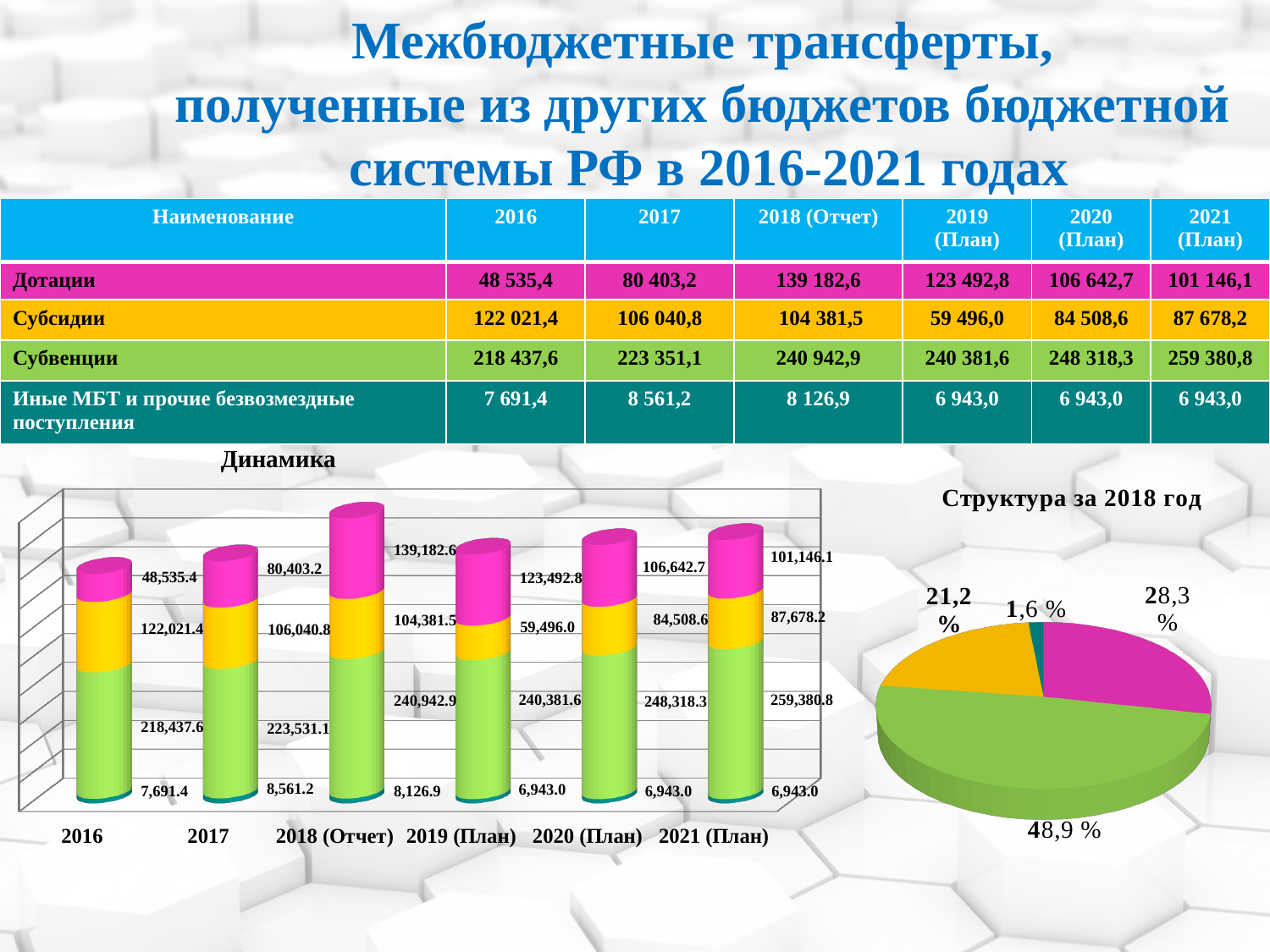
In the "Динамика" chart, what is the value of the pink (Дотации) segment for 2018 (Отчет)? 139,182.6 In the "Динамика" chart, is the yellow (Субсидии) segment larger in 2016 or in 2017? 2016 In the "Динамика" chart, what is the total of all four segments of the 2019 (План) bar? 430,313.4 In the "Динамика" chart, what is the value of the green (Субвенции) segment for 2021 (План)? 259,380.8 In the "Динамика" chart, does the pink (Дотации) segment rise or fall from 2018 (Отчет) to 2021 (План)? Falls In the pie chart "Структура за 2018 год", what share does the smallest slice have? 1,6 % In the "Динамика" chart, how many years (categories) are shown on the x axis? 6 In the pie chart "Структура за 2018 год", what share does the largest (green) slice have? 48,9 % What kind of chart is the "Динамика" chart on the left? Stacked bar chart In the "Динамика" chart, by how much does the pink (Дотации) value for 2018 (Отчет) exceed the pink value for 2017? 58,779.4 In the "Динамика" chart, which year has the largest green (Субвенции) segment? 2021 (План) In the "Динамика" chart, which year has the smallest yellow (Субсидии) segment? 2019 (План)